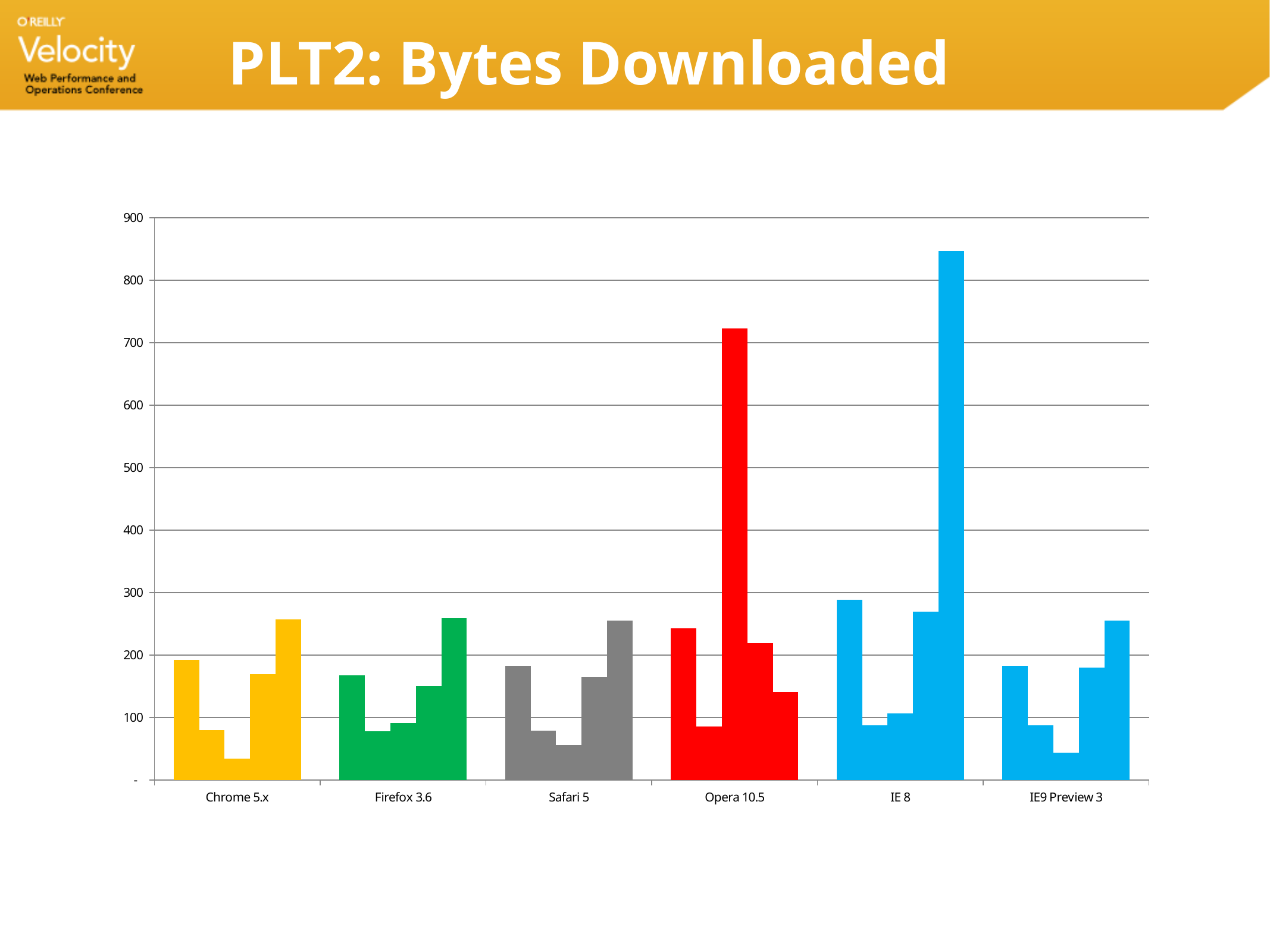
What colour are the bars for Opera 10.5? red Is the tallest bar in the IE 8 group greater or less than 800? greater Which browser category contains the tallest bar in the chart? IE 8 What kind of chart is shown on the slide? bar chart Which is taller: the tallest bar in the IE 8 group or the tallest bar in the Opera 10.5 group? IE 8 How many bars are plotted for each browser category? 5 Is the tallest bar in the Opera 10.5 group greater or less than 600? greater Is the first bar in the IE 8 group greater or less than 200? greater Which is taller: the tallest bar in the Firefox 3.6 group or the tallest bar in the IE 8 group? IE 8 What is the title of the slide containing the chart? PLT2: Bytes Downloaded How many browser categories are shown on the x axis? 6